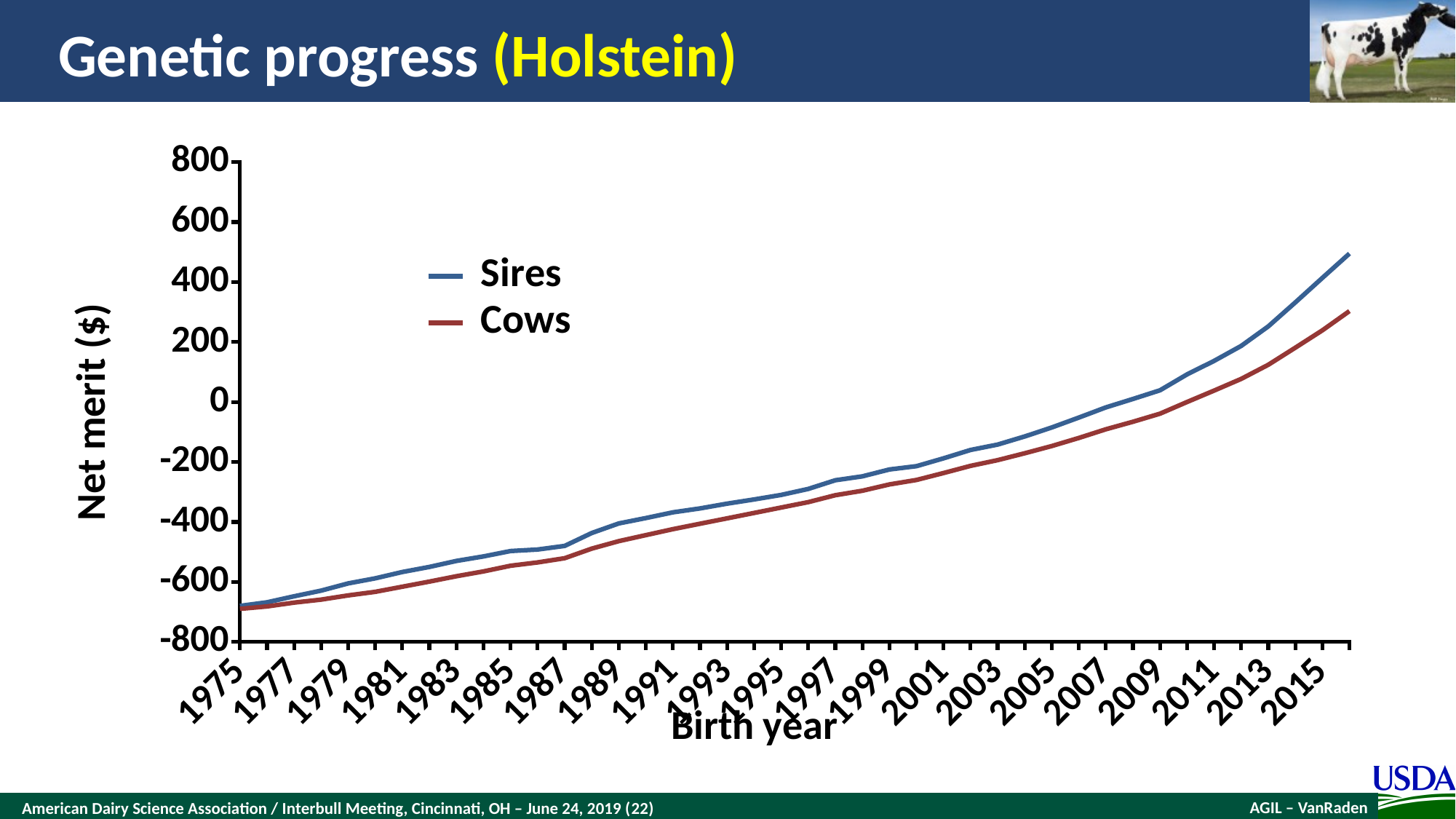
Is the Sires value for 1975 greater or less than -600? less How many series does the legend list? 2 Is the Sires value for 2013 greater or less than 200? greater Which series is higher in 2013, Sires or Cows? Sires Is the Cows value for 1987 greater or less than -400? less What kind of chart is shown on the slide? line chart Do the Cows values rise or fall as birth year increases? rise What is the title of the chart on the slide? Genetic progress (Holstein) What is the label of the y axis? Net merit ($) How many birth-year labels are shown on the x axis? 21 Do the Sires values rise or fall as birth year increases? rise